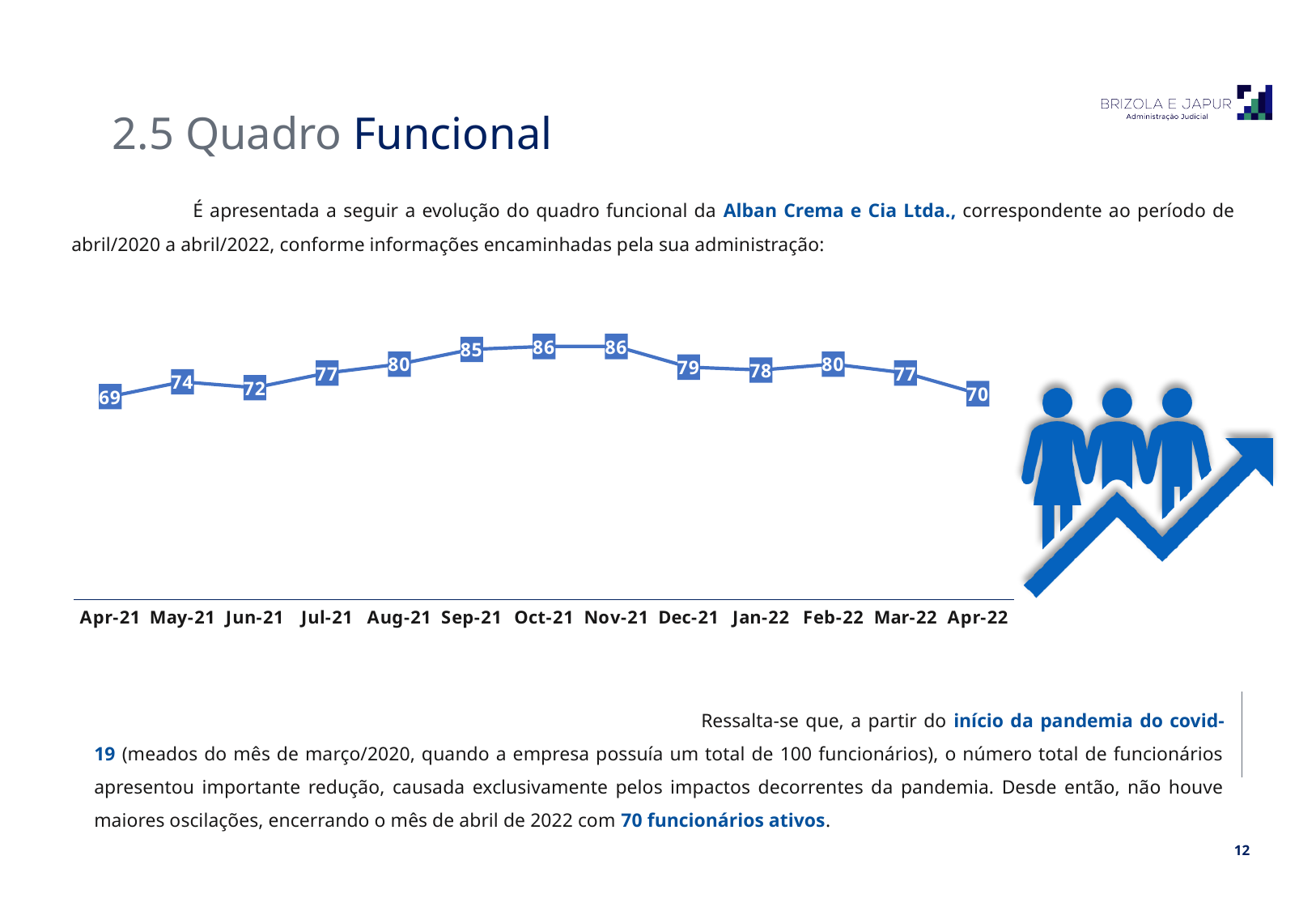
Do the values rise or fall from Nov-21 to Apr-22? fall What is the difference between the values for Oct-21 and Apr-21? 17 What is the value for Jan-22? 78 What type of chart is shown on the slide? line chart What is the value for Apr-21? 69 What is the value for Apr-22? 70 What is the value for Sep-21? 85 How many months are plotted on the chart? 13 What is the difference between the values for Nov-21 and Dec-21? 7 What is the highest value shown on the chart? 86 Which is larger, the value for May-21 or the value for Jun-21? May-21 Which month has the lowest value? Apr-21